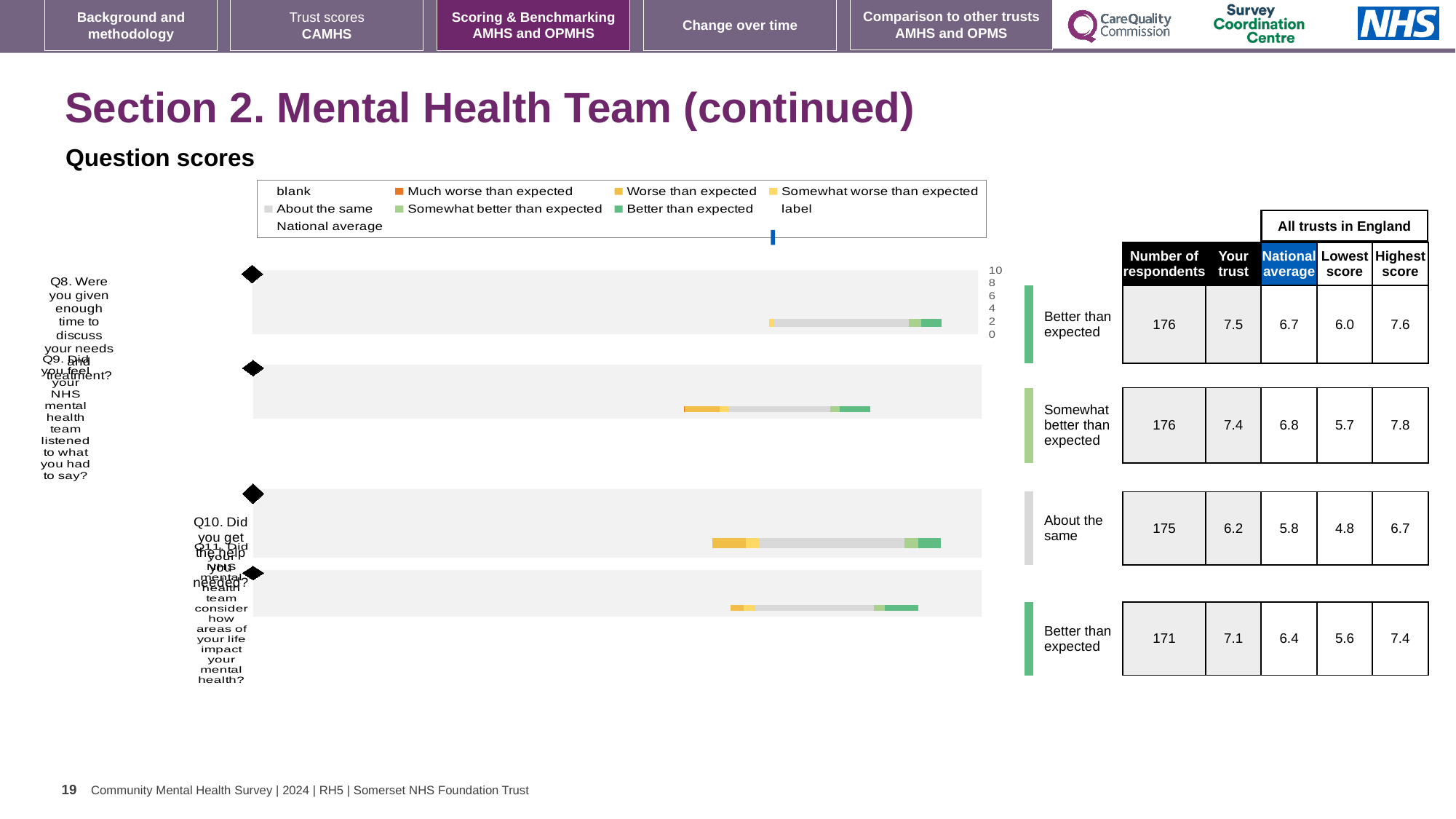
What is the maximum value shown on the score axis of the Q8 chart? 10 In the table beside the charts, what is the 'Your trust' score for Q8 (enough time to discuss needs and treatment)? 7.5 Which question has the lowest 'Your trust' score in the table beside the charts? Q10 In the table beside the charts, what is the lowest score among all trusts in England for Q10 (did you get the help you needed)? 4.8 Which question has the highest 'Your trust' score in the table beside the charts? Q8 For Q8, which is larger in the table beside the charts: the 'Your trust' score or the national average? Your trust In the table beside the charts, what is the highest score among all trusts in England for Q9? 7.8 For Q11, what is the difference between the 'Your trust' score and the national average in the table beside the charts? 0.7 In the table beside the charts, how many respondents answered Q11 (team considered how areas of your life impact your mental health)? 171 How many question charts (Q8 to Q11) are shown on the slide? 4 In the table beside the charts, what is the national average for Q9 (mental health team listened to what you had to say)? 6.8 What kind of chart is used to show the question scores for Q8 to Q11? bar chart